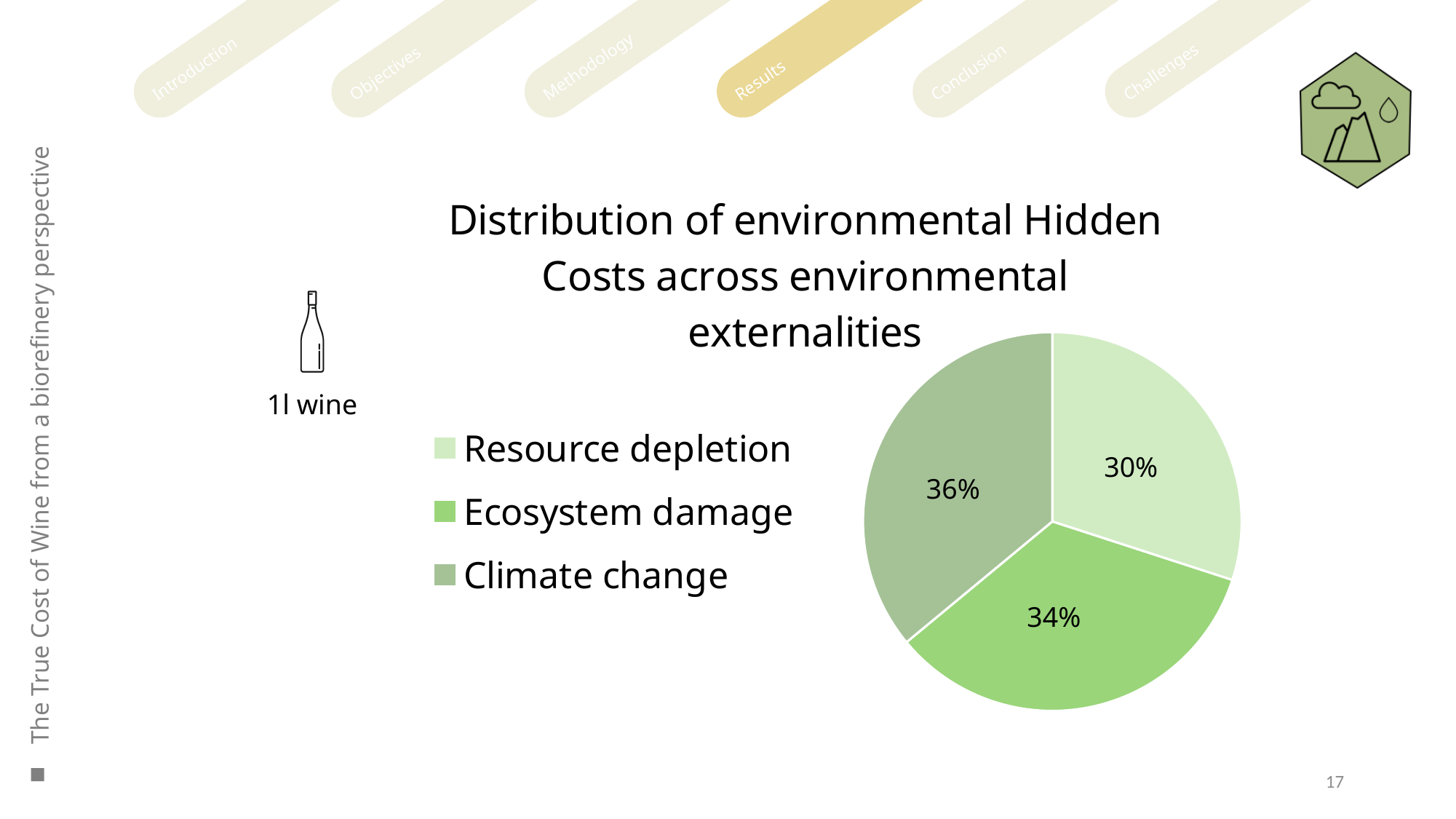
What share of the pie does Resource depletion account for? 30% What share of the pie does Climate change account for? 36% Which category has the smallest share of the pie? Resource depletion What share of the pie does Ecosystem damage account for? 34% What is the title of the chart? Distribution of environmental Hidden Costs across environmental externalities Which category has the largest share of the pie? Climate change How many slices does the pie chart have? 3 What is the difference in percentage points between the Ecosystem damage share and the Resource depletion share? 4 What is the difference in percentage points between the Climate change share and the Resource depletion share? 6 Which is larger, the share for Ecosystem damage or the share for Resource depletion? Ecosystem damage What kind of chart is shown on the slide? pie chart How many entries does the legend list? 3